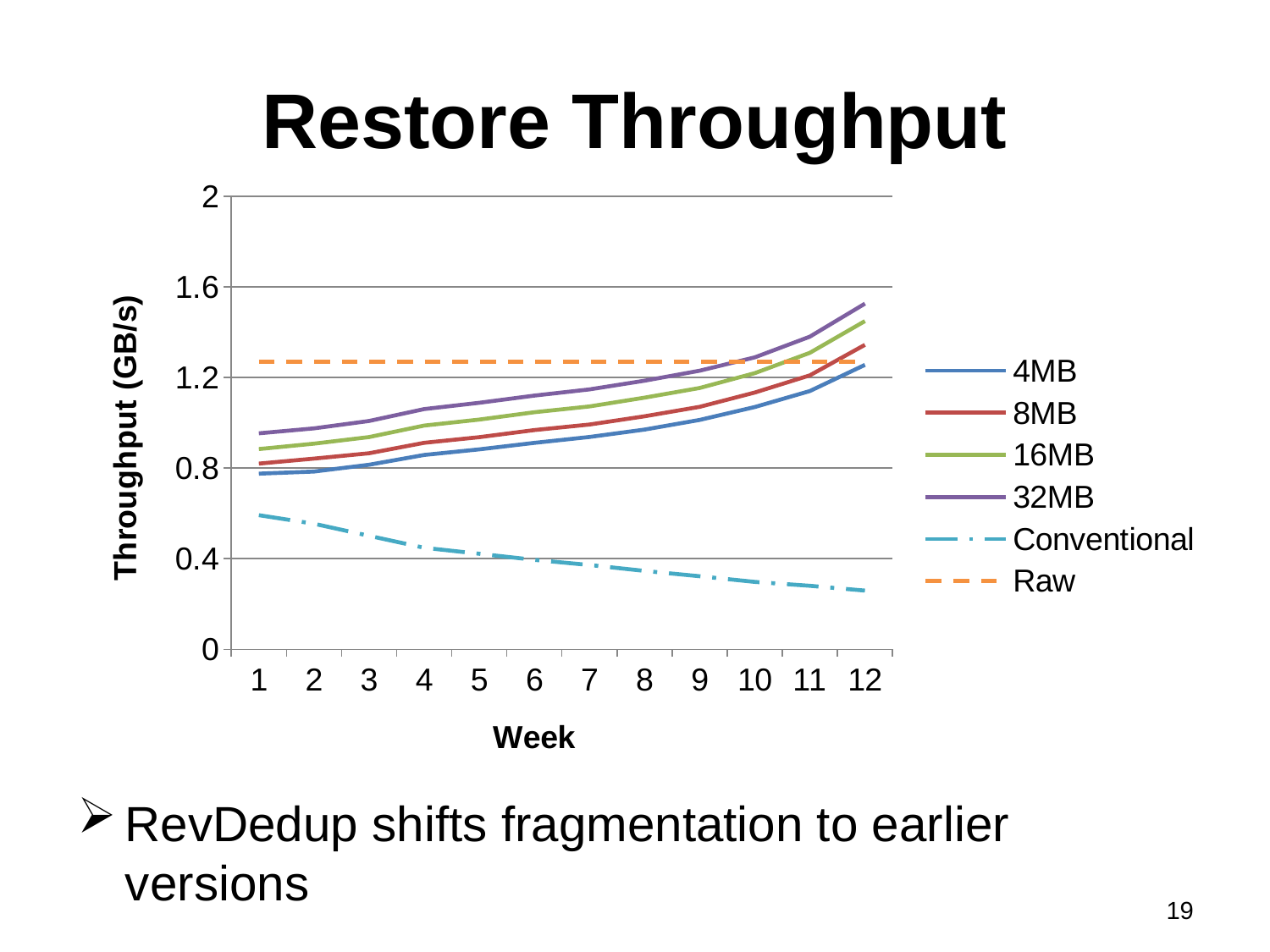
Does the 4MB series rise or fall from week 1 to week 12? rise How many weeks are plotted along the x axis? 12 At week 1, which is larger: the 4MB throughput or the Conventional throughput? 4MB How many series does the legend list? 6 Which series has the lowest throughput at week 12? Conventional Does the Conventional series rise or fall from week 1 to week 12? fall What kind of chart is shown on the slide? line chart Is the 32MB throughput at week 12 greater or less than 1.2? greater Which series has the highest throughput at week 12? 32MB What is the label of the y axis? Throughput (GB/s) Is the Conventional throughput at week 12 greater or less than 0.4? less What is the title of the chart? Restore Throughput